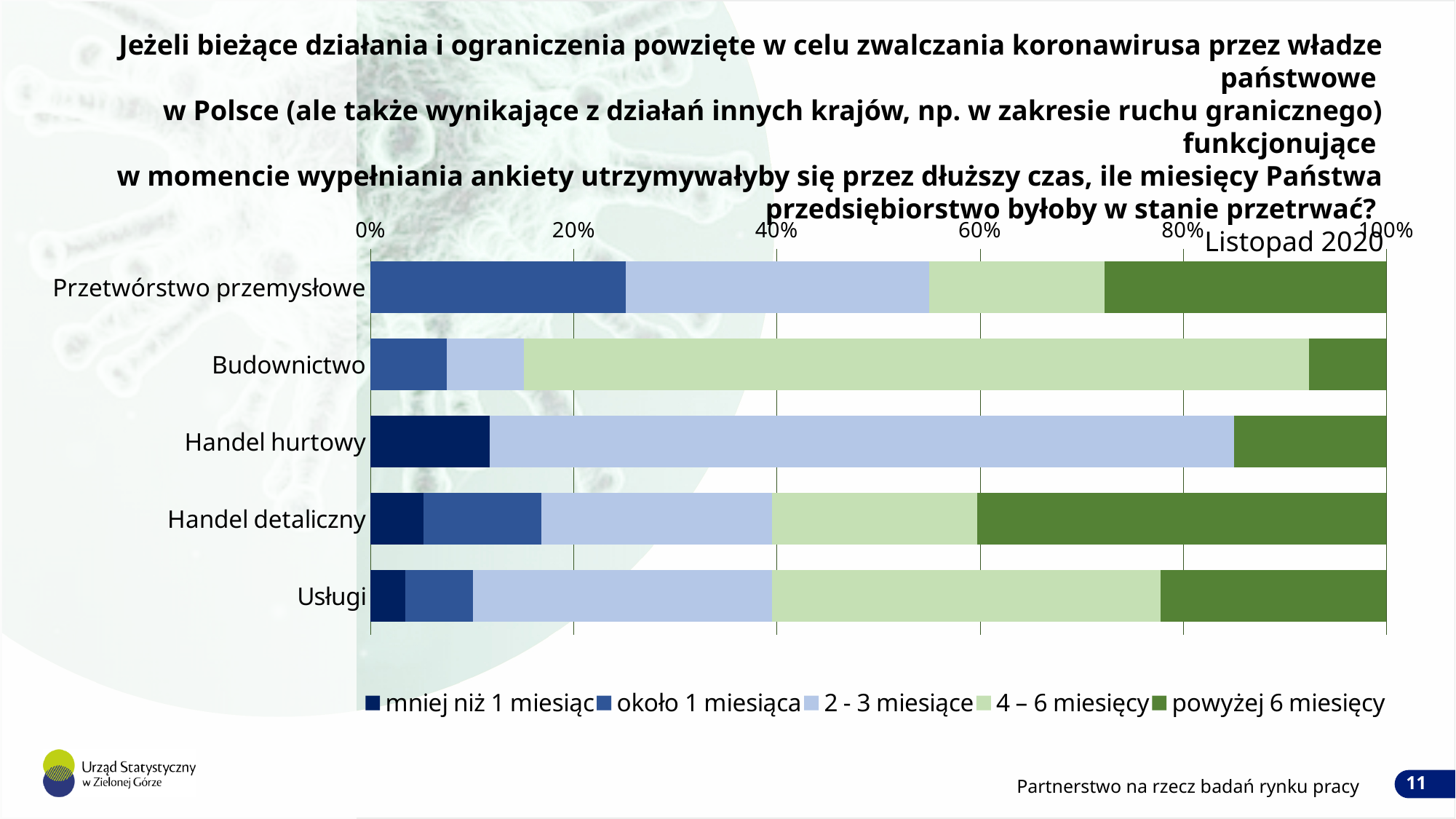
Which month and year is indicated next to the chart? Listopad 2020 Which category has the largest share for '4 – 6 miesięcy'? Budownictwo Is the '4 – 6 miesięcy' share for Budownictwo greater or less than 60%? greater Which category has the smallest share for 'powyżej 6 miesięcy'? Budownictwo Is the '2 - 3 miesiące' share for Handel hurtowy greater or less than 60%? greater How many series does the legend list? 5 Which has a larger '4 – 6 miesięcy' share: Budownictwo or Przetwórstwo przemysłowe? Budownictwo How many categories (industry sectors) are shown on the chart? 5 Is the 'około 1 miesiąca' share for Przetwórstwo przemysłowe greater or less than 20%? greater Which has a larger '2 - 3 miesiące' share: Handel hurtowy or Usługi? Handel hurtowy What kind of chart is shown on the slide? stacked bar chart Which category has the largest share for 'powyżej 6 miesięcy'? Handel detaliczny